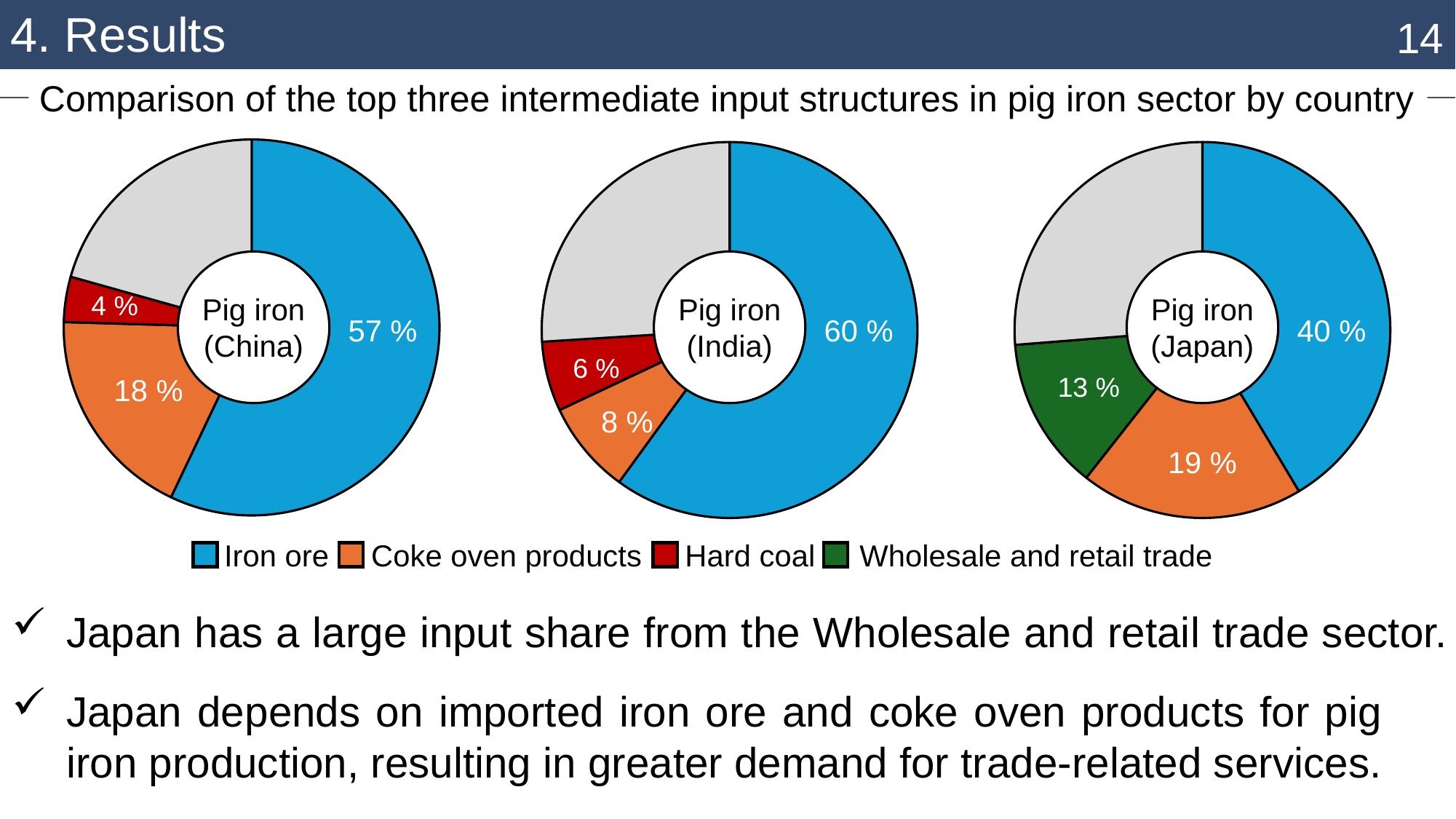
What is the difference between the Iron ore share in the Pig iron (India) chart and the Iron ore share in the Pig iron (Japan) chart? 20 % In the Pig iron (Japan) chart, which labelled input has the largest share? Iron ore In the Pig iron (India) chart, which labelled input has the smallest share? Hard coal What kind of chart is used to show the input structures on this slide? Pie chart In the Pig iron (China) chart, what is the combined share of Iron ore and Coke oven products? 75 % In the Pig iron (China) chart, what share does Iron ore have? 57 % In the Pig iron (Japan) chart, what share does Wholesale and retail trade have? 13 % How many entries does the legend list? 4 In the Pig iron (India) chart, what share does Coke oven products have? 8 % Which is larger: the Coke oven products share in the Pig iron (China) chart or in the Pig iron (Japan) chart? Pig iron (Japan) Which colour represents Hard coal in the legend? Red In the Pig iron (China) chart, what share does Hard coal have? 4 %